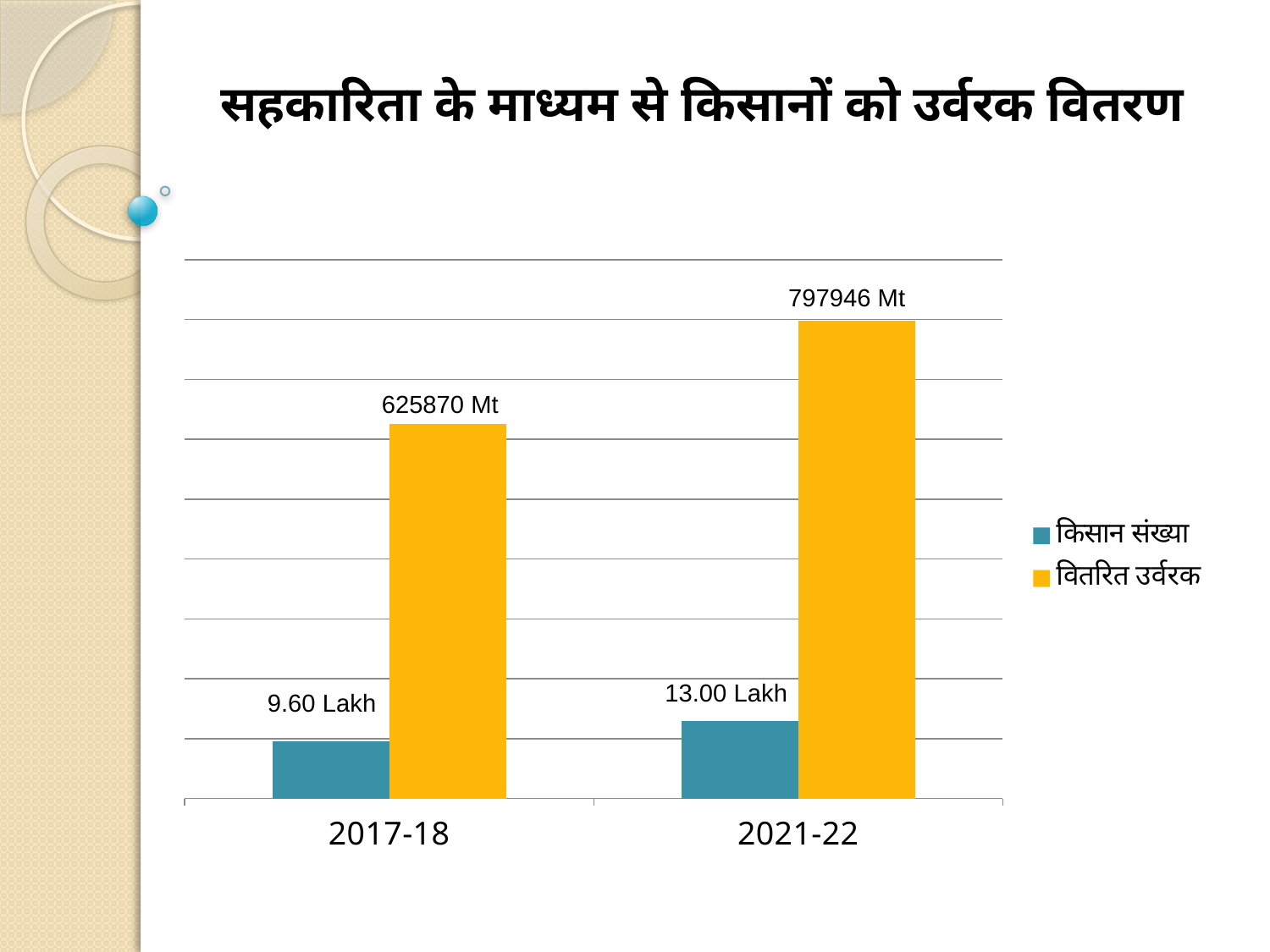
Is the किसान संख्या value larger in 2017-18 or in 2021-22? 2021-22 What is the difference in वितरित उर्वरक between 2021-22 and 2017-18? 172076 Mt What is the difference in किसान संख्या between 2021-22 and 2017-18? 3.40 Lakh What is the value of किसान संख्या for 2017-18? 9.60 Lakh What is the value of वितरित उर्वरक for 2021-22? 797946 Mt How many series does the legend list? 2 Which year has the higher value for वितरित उर्वरक? 2021-22 Which year has the lower value for किसान संख्या? 2017-18 What is the value of किसान संख्या for 2021-22? 13.00 Lakh What is the value of वितरित उर्वरक for 2017-18? 625870 Mt How many year categories are shown on the x axis? 2 What kind of chart is shown on the slide? Bar chart